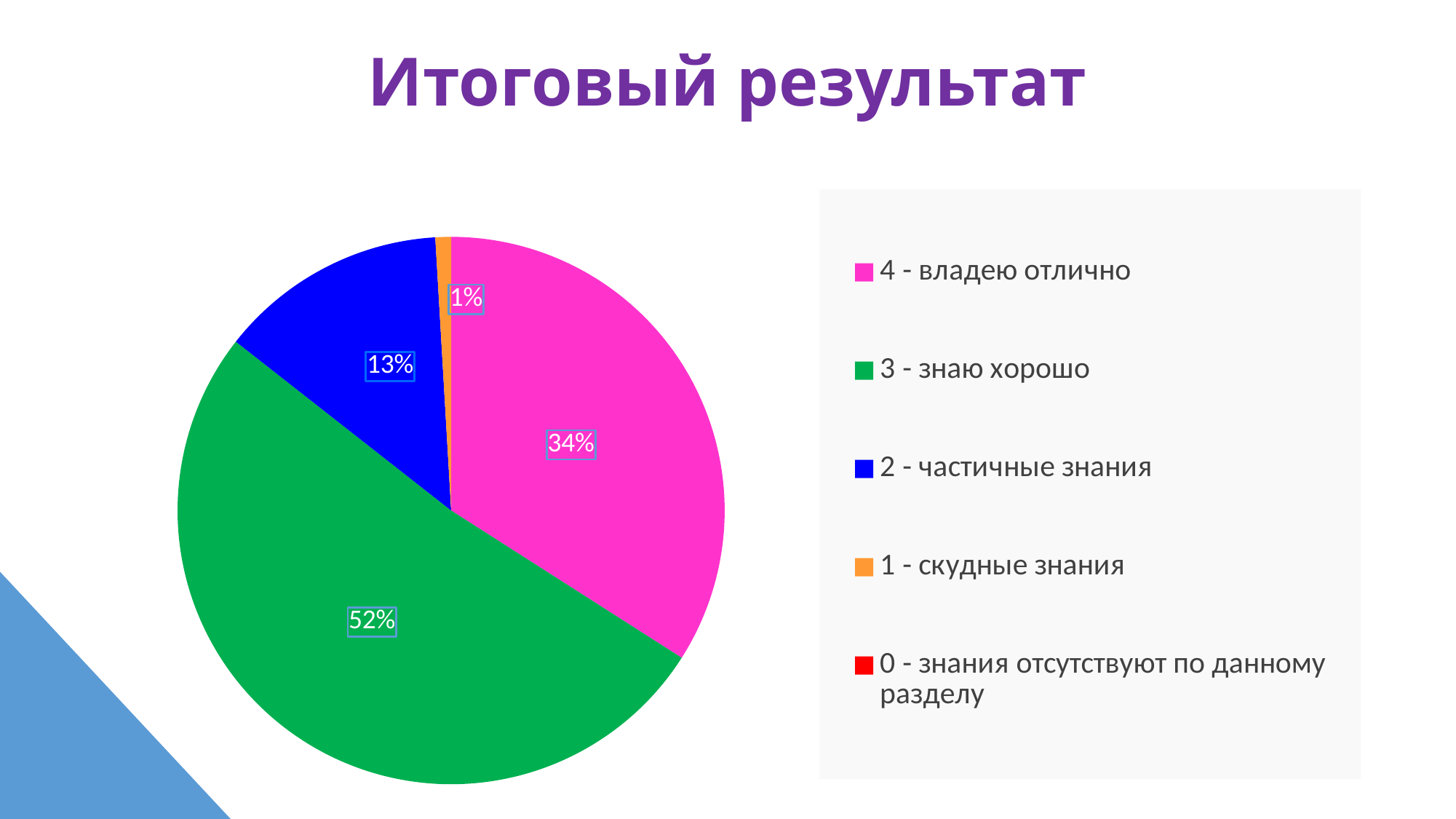
What is the title of the chart? Итоговый результат What share of the pie does "1 - скудные знания" take? 1% What kind of chart is shown on the slide? pie chart Which labelled slice is the smallest in the pie? 1 - скудные знания Which category has the largest slice of the pie? 3 - знаю хорошо What share of the pie does "2 - частичные знания" take? 13% How many entries does the legend list? 5 What share of the pie does "4 - владею отлично" take? 34% What colour is the slice for "2 - частичные знания"? blue What is the difference between the shares of "3 - знаю хорошо" and "4 - владею отлично"? 18% Which is larger: the slice for "4 - владею отлично" or the slice for "2 - частичные знания"? 4 - владею отлично